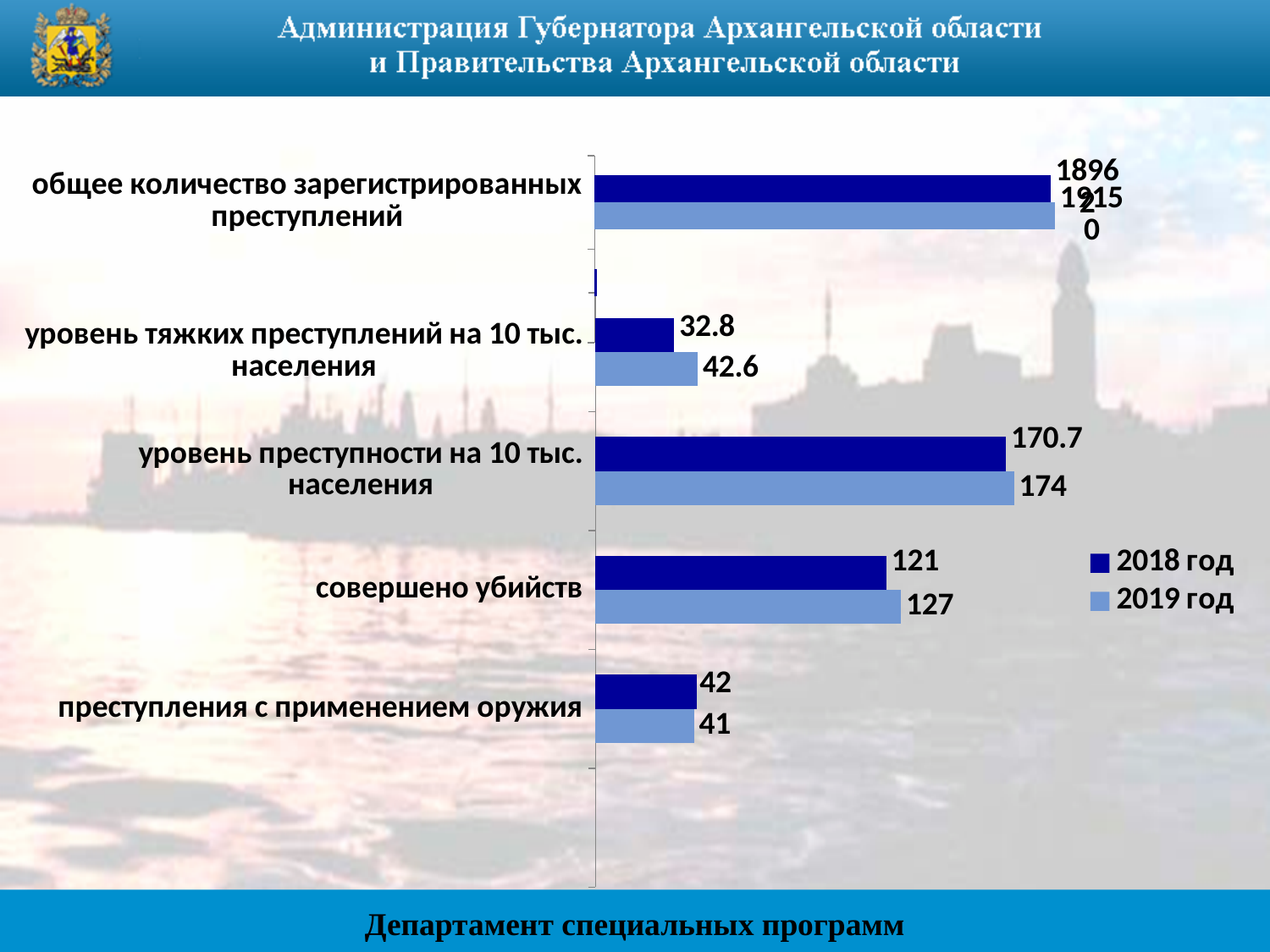
For 'преступления с применением оружия', which year has the larger value, 2018 год or 2019 год? 2018 год What are the two series named in the legend? 2018 год and 2019 год What is the value for 'уровень тяжких преступлений на 10 тыс. населения' in 2019 год? 42.6 What kind of chart is shown on the slide? bar chart What is the value for 'уровень тяжких преступлений на 10 тыс. населения' in 2018 год? 32.8 What is the difference between the 2019 год and 2018 год values for 'уровень тяжких преступлений на 10 тыс. населения'? 9.8 What is the value for 'уровень преступности на 10 тыс. населения' in 2019 год? 174 What is the value for 'совершено убийств' in 2018 год? 121 What is the value for 'преступления с применением оружия' in 2019 год? 41 How many series does the legend list? 2 What is the difference between the 2019 год and 2018 год values for 'совершено убийств'? 6 For 'уровень преступности на 10 тыс. населения', which year has the larger value, 2018 год or 2019 год? 2019 год